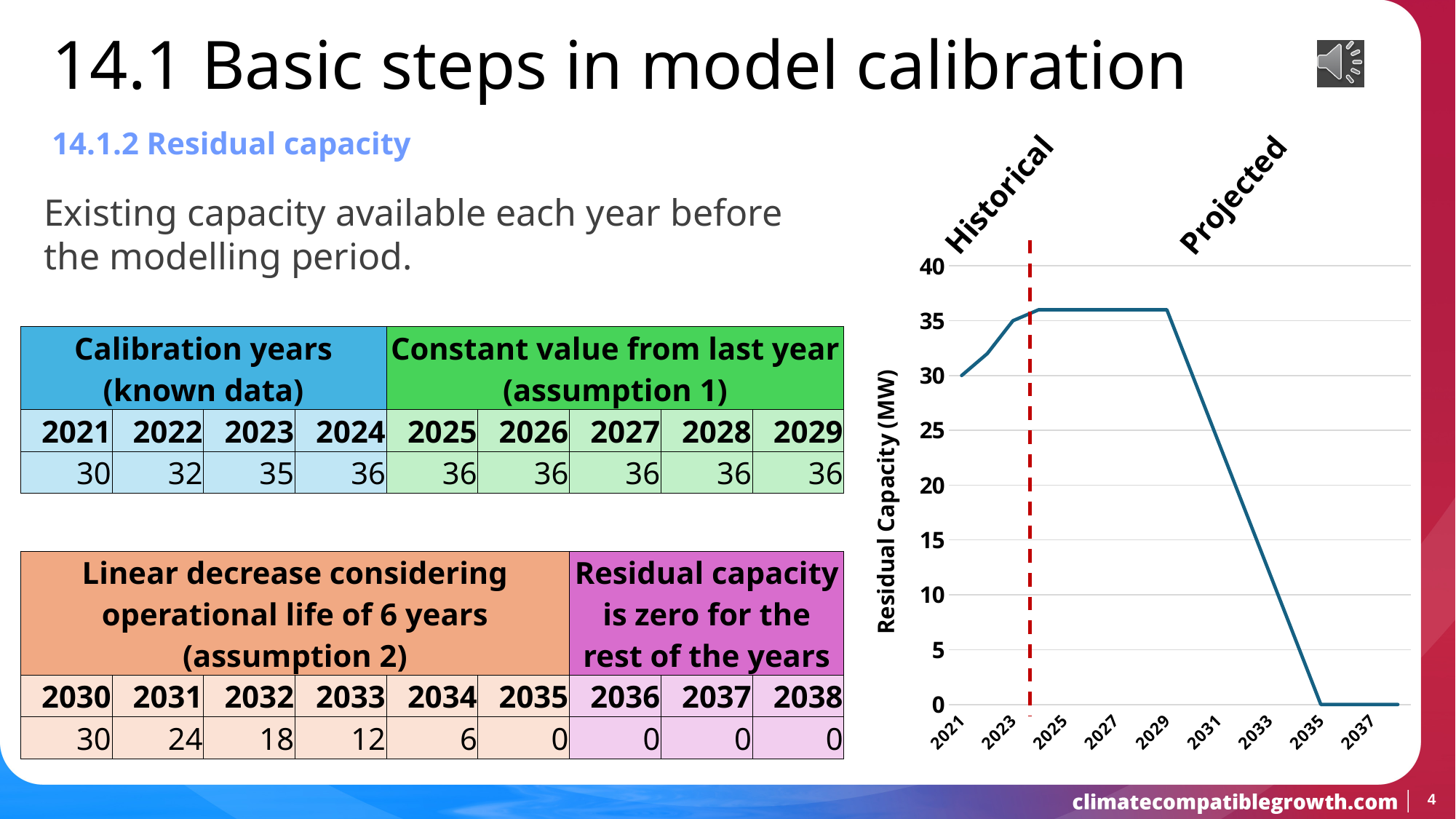
What is the residual capacity in 2021 on the chart? 30 What kind of chart is shown on the right of the slide? line chart What is the residual capacity in 2035 on the chart? 0 What two periods does the red dashed line on the chart separate? Historical and Projected Which year has the larger residual capacity, 2023 or 2032? 2023 Is the residual capacity for 2033 greater or less than 15? less Is the residual capacity for 2031 greater or less than 20? greater What is the difference between the residual capacity in 2024 and in 2021? 6 Does the residual capacity rise or fall between 2021 and 2024? rise What is the label on the vertical axis of the chart? Residual Capacity (MW) Does the residual capacity rise or fall between 2029 and 2035? fall What is the residual capacity in 2029 on the chart? 36